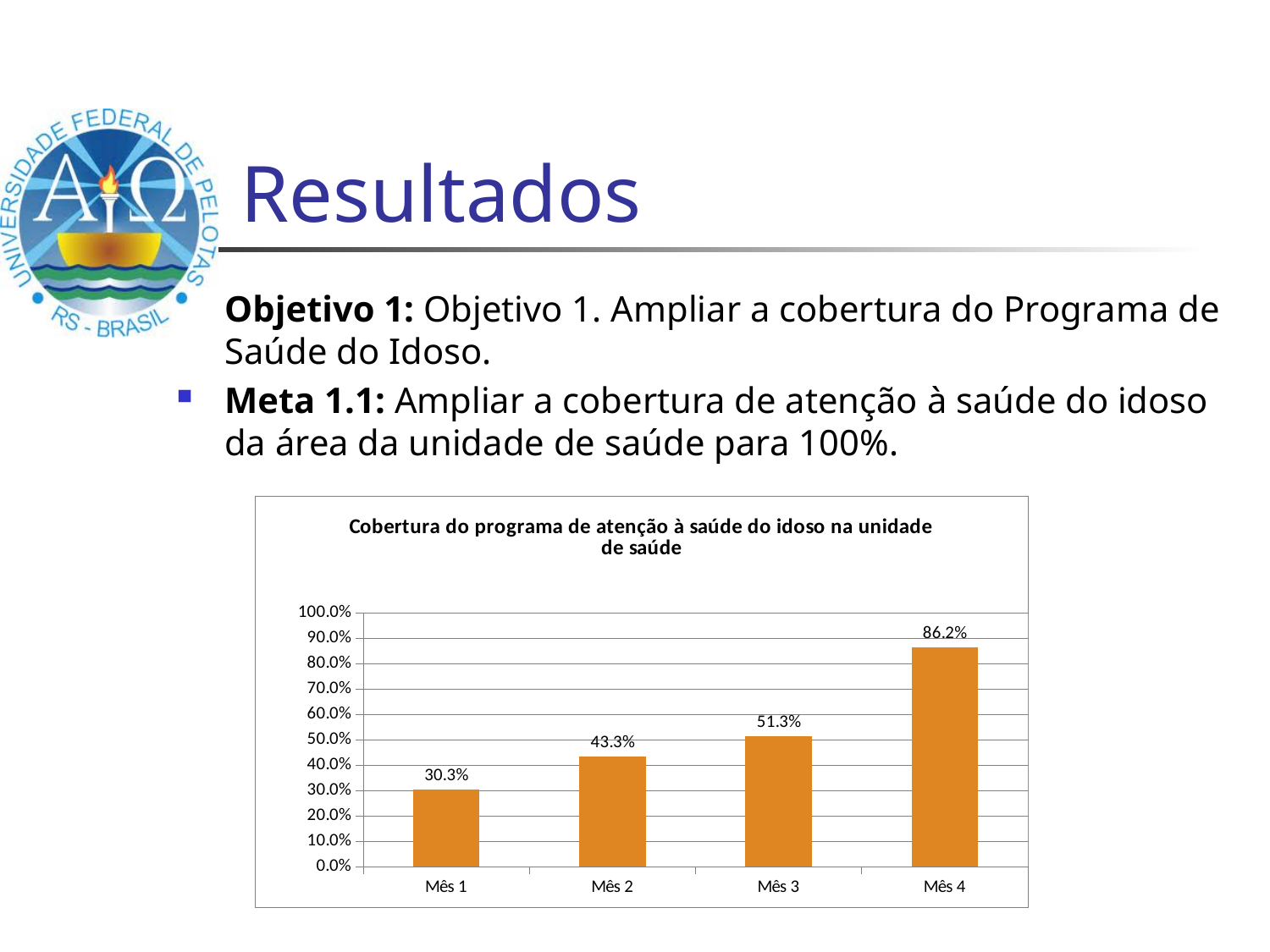
Which month has the highest coverage value? Mês 4 What is the value for Mês 4? 86.2% Which month has the lowest coverage value? Mês 1 What is the difference between the values for Mês 2 and Mês 1? 13.0% Do the values rise or fall from Mês 1 to Mês 4? Rise What kind of chart is shown on the slide? Bar chart What is the value for Mês 3? 51.3% What is the value for Mês 2? 43.3% What is the difference between the values for Mês 4 and Mês 3? 34.9% Which is larger, the value for Mês 2 or the value for Mês 3? Mês 3 What is the value for Mês 1? 30.3% How many months (categories) are shown on the x axis? 4